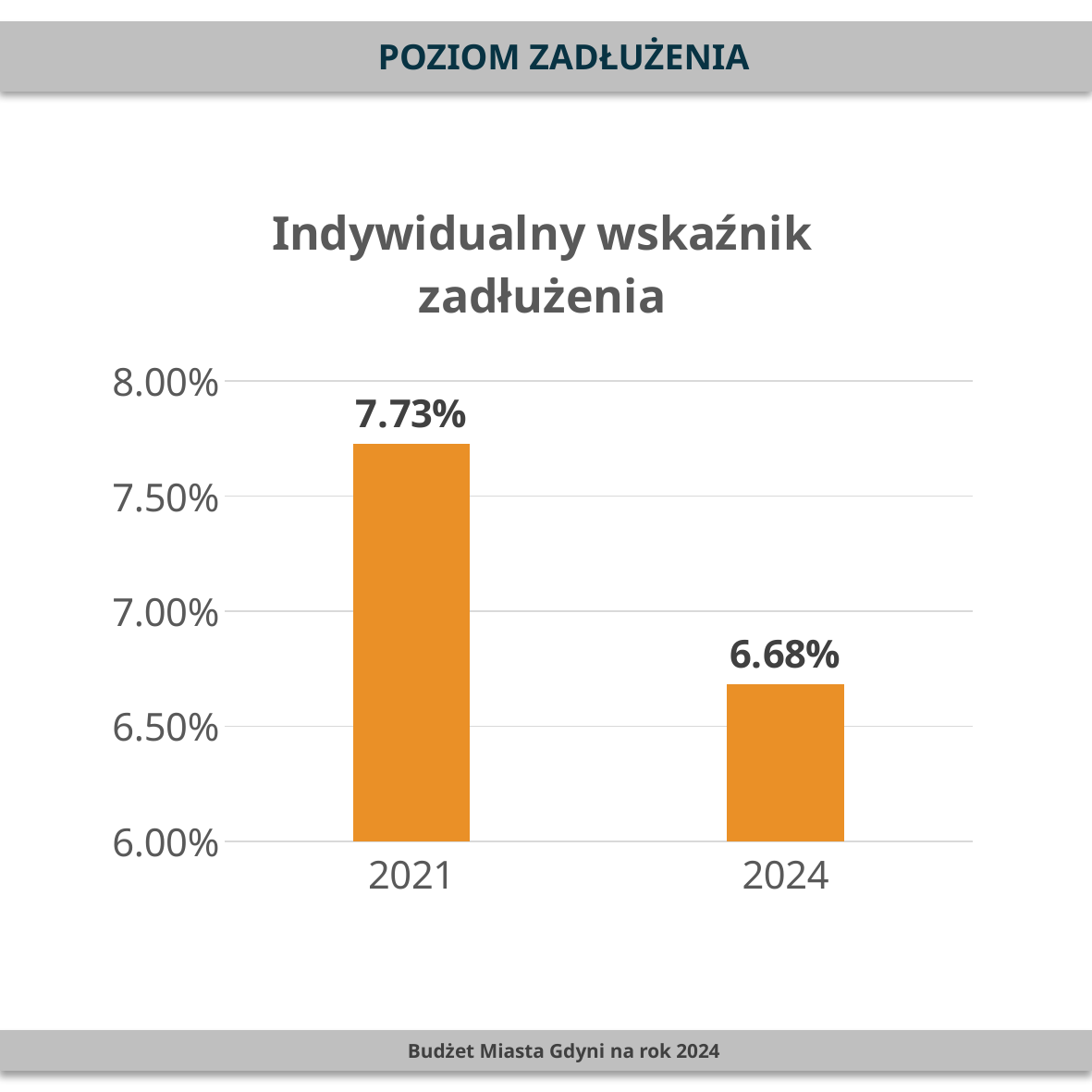
Is the value for 2021 greater or less than 7.50%? greater Is the value for 2024 greater or less than 7.00%? less What kind of chart is shown? bar chart Which year has the lowest value? 2024 What is the title of the chart? Indywidualny wskaźnik zadłużenia Which year has the highest value? 2021 Which is larger, the value for 2021 or the value for 2024? 2021 What is the value for 2024? 6.68% How many categories are shown on the x axis? 2 What is the value for 2021? 7.73% What is the difference between the values for 2021 and 2024? 1.05% Do the values rise or fall from 2021 to 2024? fall